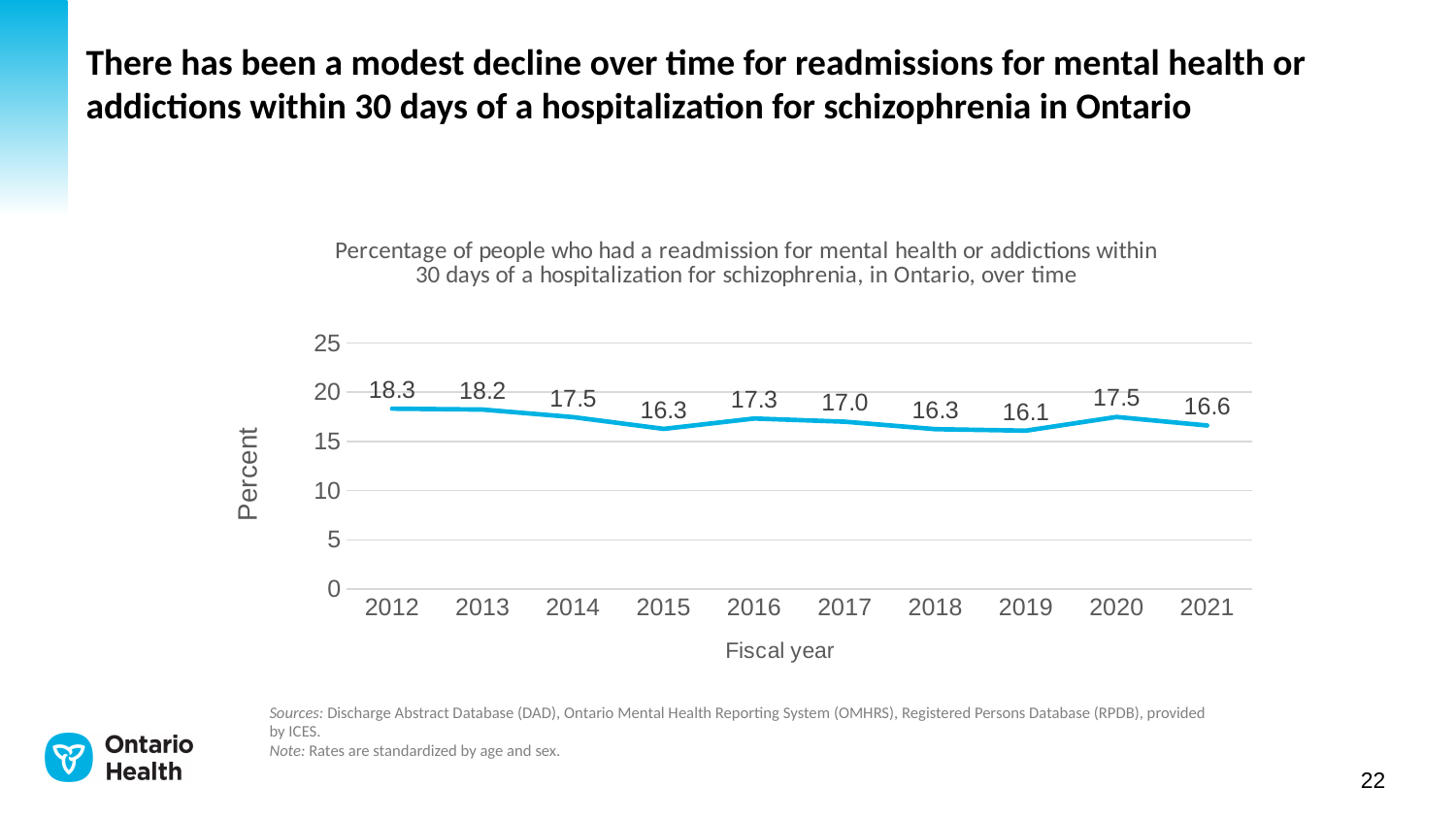
What is the difference between the readmission percentage in 2012 and in 2021? 1.7 What is the readmission percentage for fiscal year 2017? 17.0 Which fiscal year has the lowest readmission percentage? 2019 Which fiscal year has the highest readmission percentage? 2012 What is the label on the x axis of the chart? Fiscal year Which fiscal year has a higher readmission percentage, 2016 or 2018? 2016 What is the readmission percentage for fiscal year 2012? 18.3 What kind of chart is shown on the slide? line chart What is the readmission percentage for fiscal year 2021? 16.6 Is the value for 2019 greater or less than 20? less How many fiscal years are plotted on the chart? 10 Overall, do the readmission percentages rise or fall from 2012 to 2021? fall